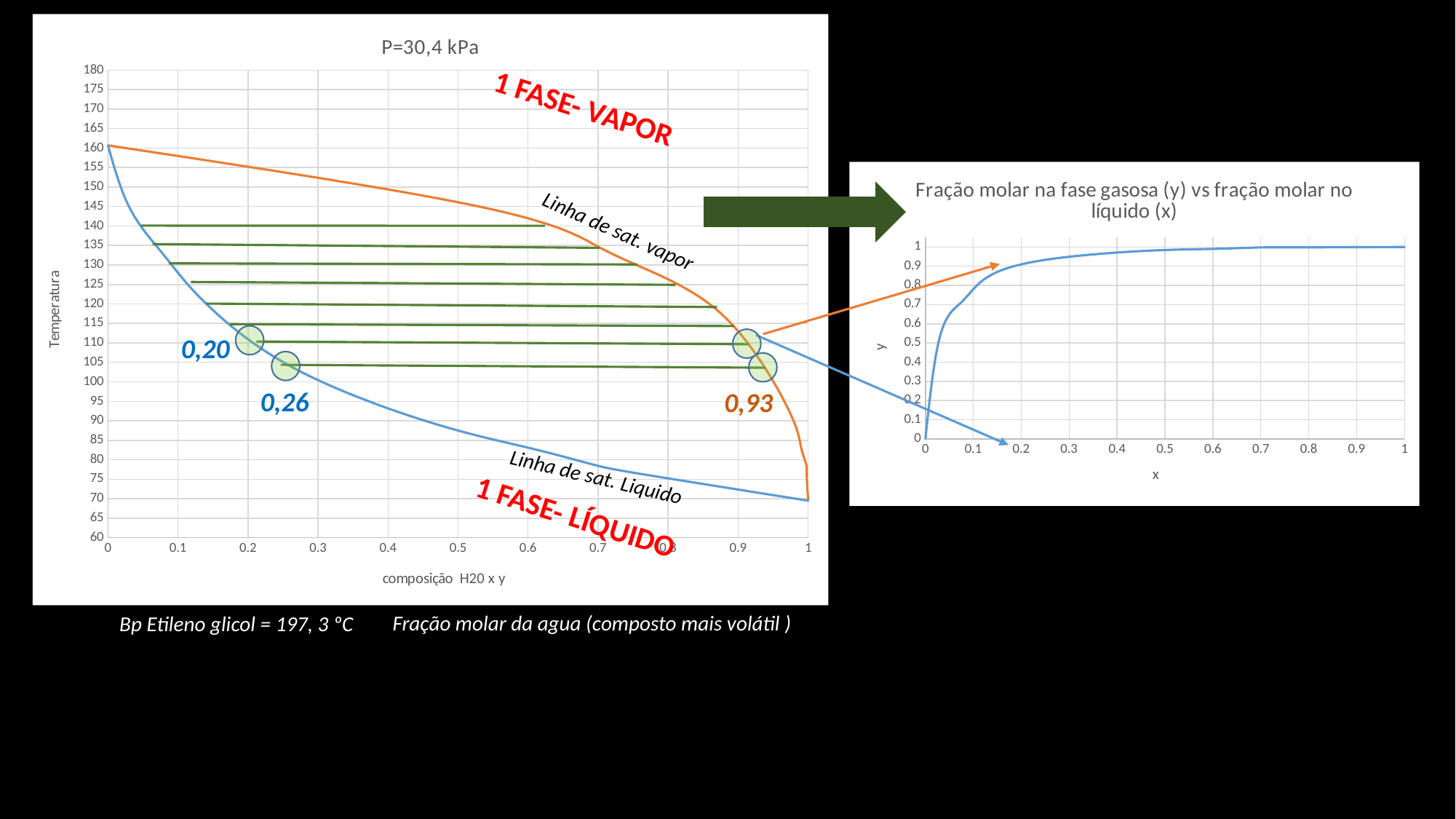
In the chart titled "P=30,4 kPa", do the saturation curves rise or fall as the composition increases from 0 to 1? fall In the chart titled "P=30,4 kPa", what is the label of the y axis? Temperatura In the chart titled "P=30,4 kPa", is the temperature on the Linha de sat. Liquido at composition 0.5 greater or less than 100? less In the chart on the right titled "Fração molar na fase gasosa (y) vs fração molar no líquido (x)", does y rise or fall as x increases? rise What is the title of the chart on the left of the slide? P=30,4 kPa In the chart on the right titled "Fração molar na fase gasosa (y) vs fração molar no líquido (x)", is the value of y at x = 0.5 greater or less than 0.9? greater In the chart titled "P=30,4 kPa", at composition 0.5, which curve has the higher temperature, Linha de sat. vapor or Linha de sat. Liquido? Linha de sat. vapor What kind of chart is the one on the right titled "Fração molar na fase gasosa (y) vs fração molar no líquido (x)"? line chart In the chart titled "P=30,4 kPa", what composition value is annotated at the circled point on the liquid saturation line at about 110 °C? 0,20 In the chart titled "P=30,4 kPa", what composition value is annotated at the circled point on the vapor saturation line? 0,93 In the chart titled "P=30,4 kPa", what are the names of the two curves plotted? Linha de sat. vapor and Linha de sat. Liquido In the chart titled "P=30,4 kPa", is the temperature on the Linha de sat. vapor at composition 0.5 greater or less than 140? greater